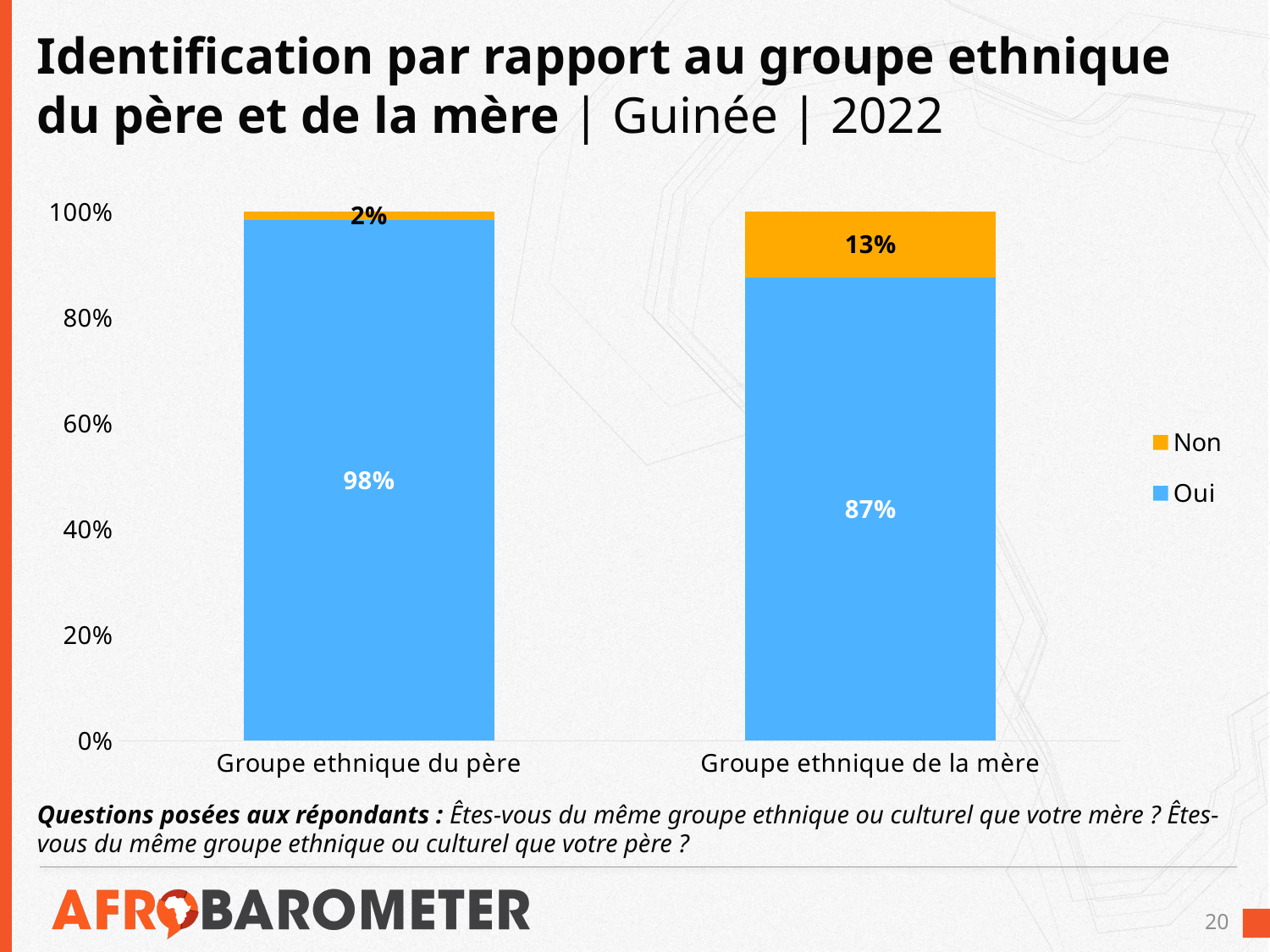
How many categories are shown on the x axis? 2 What is the 'Non' value for 'Groupe ethnique du père'? 2% Which category has the higher 'Oui' value? Groupe ethnique du père What is the difference between the 'Oui' values for 'Groupe ethnique du père' and 'Groupe ethnique de la mère'? 11 percentage points Which category has the lower 'Non' value? Groupe ethnique du père Is the 'Non' value larger for 'Groupe ethnique du père' or 'Groupe ethnique de la mère'? Groupe ethnique de la mère What kind of chart is shown on the slide? Stacked bar chart What is the 'Oui' value for 'Groupe ethnique de la mère'? 87% What is the 'Non' value for 'Groupe ethnique de la mère'? 13% What is the 'Oui' value for 'Groupe ethnique du père'? 98% How many series does the legend list? 2 Is the 'Oui' value for 'Groupe ethnique de la mère' greater or less than 80%? greater